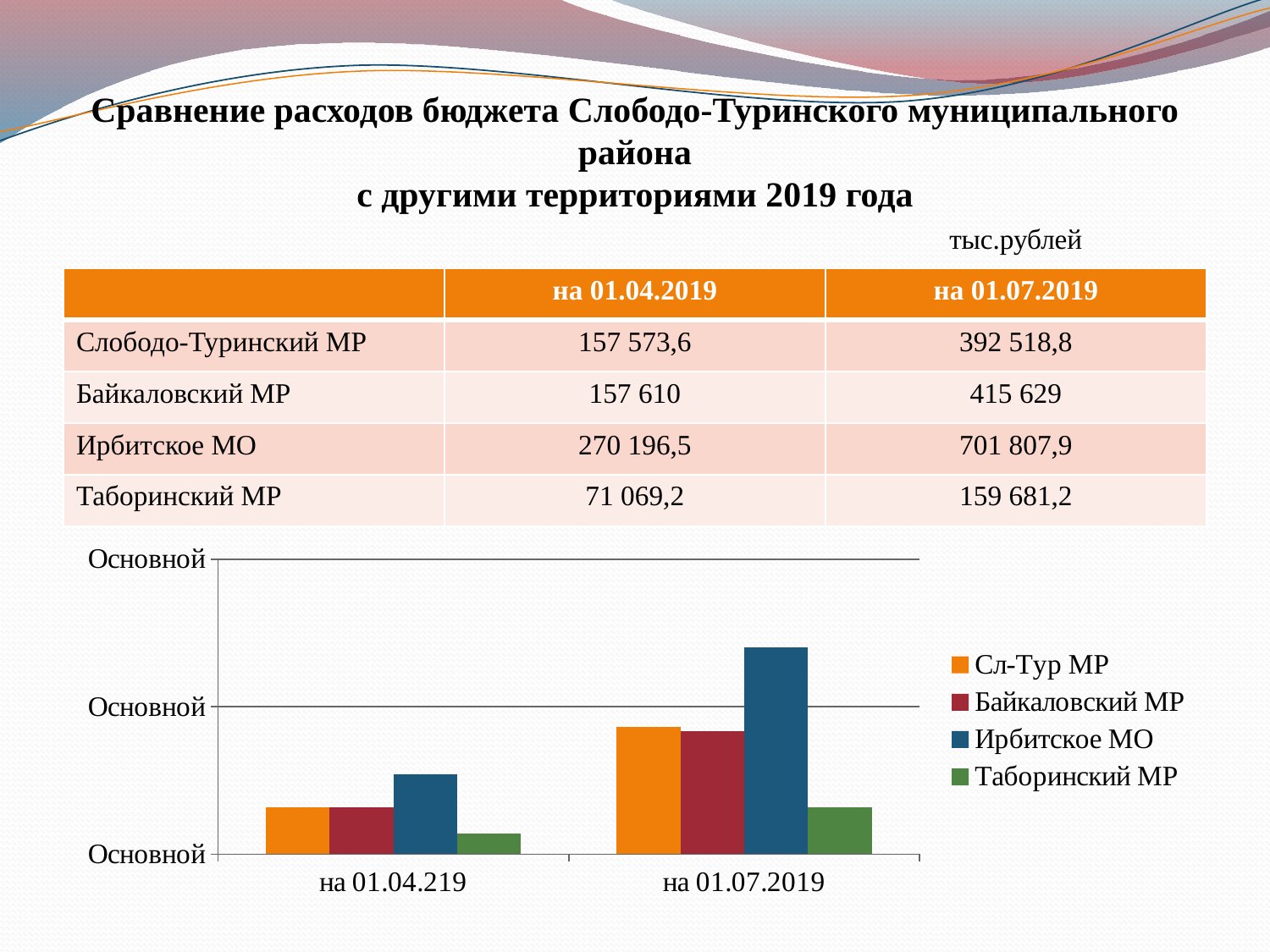
Which territory has the highest bar for на 01.07.2019? Ирбитское МО For на 01.07.2019, which is larger: the bar for Ирбитское МО or the bar for Сл-Тур МР? Ирбитское МО Do the bars for Сл-Тур МР rise or fall from на 01.04.219 to на 01.07.2019? rise According to the table, what is the value for Таборинский МР на 01.04.2019? 71 069,2 How many categories are shown along the x axis of the chart? 2 According to the table, what is the difference between the values for Ирбитское МО на 01.07.2019 and на 01.04.2019? 431 611,4 What colour are the bars for Ирбитское МО in the chart? blue Which territory has the lowest bar for на 01.04.219? Таборинский МР What is the first entry in the chart legend? Сл-Тур МР How many series does the chart legend list? 4 According to the table, what is the value for Слободо-Туринский МР на 01.07.2019? 392 518,8 What kind of chart is shown on the slide? bar chart